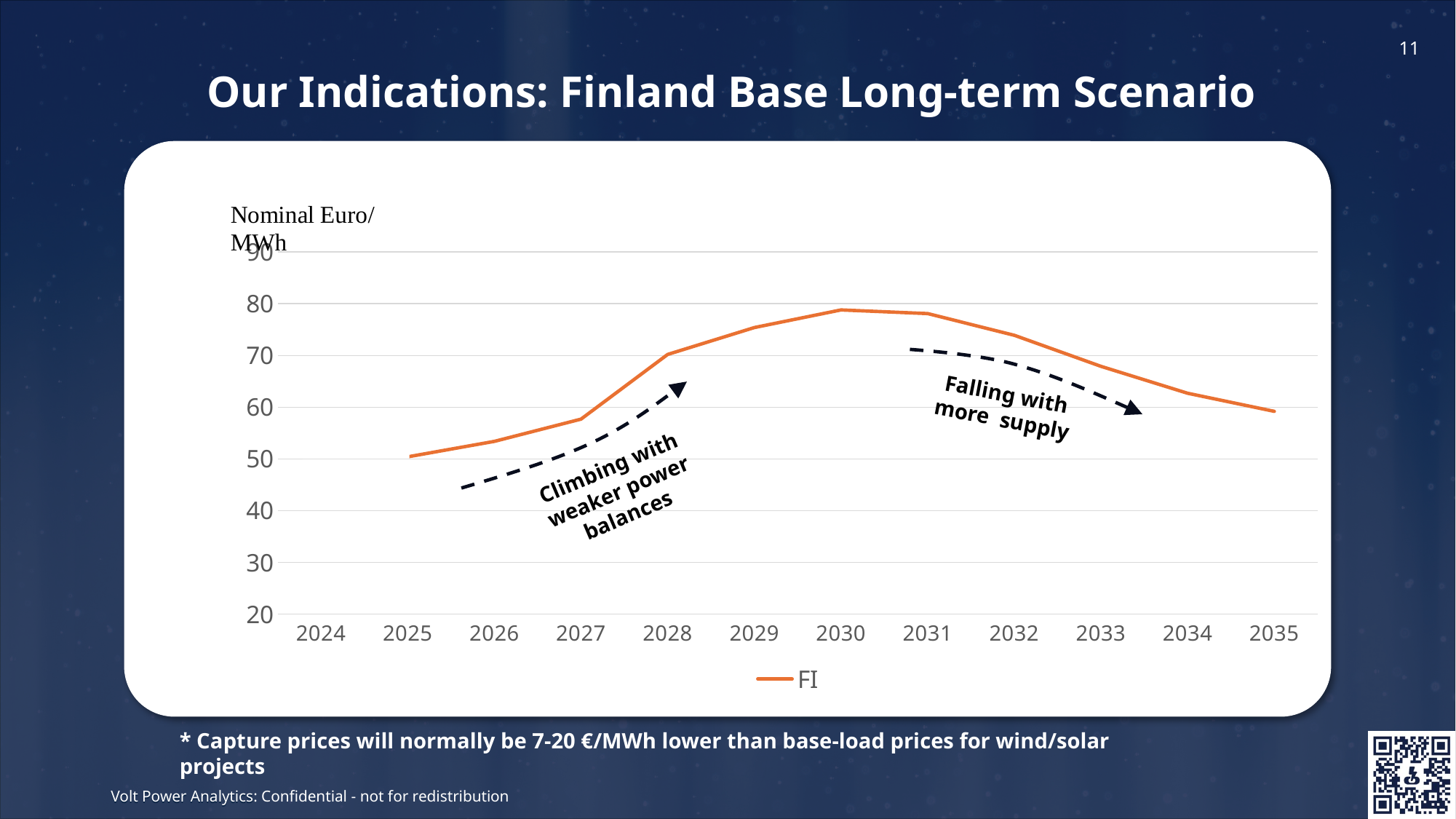
Is the value for FI in 2030 greater or less than 70? greater Is the value for FI in 2028 greater or less than 60? greater Is the value for FI in 2035 greater or less than 70? less Which is larger, the FI value in 2032 or in 2035? 2032 What is the name of the series shown in the legend? FI How many year labels are shown on the x axis? 12 Do the FI values rise or fall from 2031 to 2035? fall What unit is given for the y axis of the chart? Nominal Euro/MWh What kind of chart is shown on the slide? Line chart Which year has the lowest value for FI? 2025 How many series does the legend list? 1